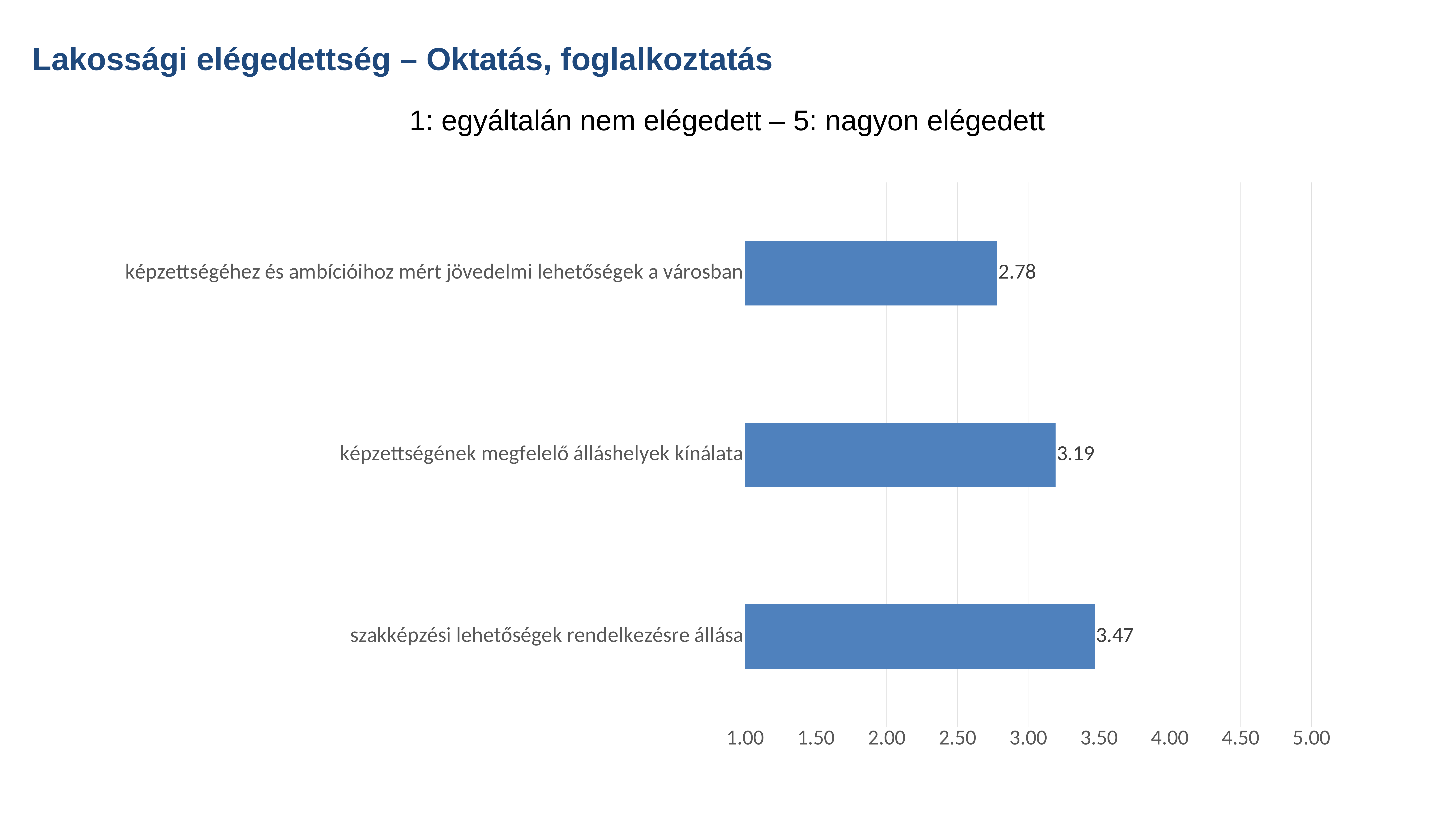
How many categories are shown in the chart? 3 Which category has the highest value? szakképzési lehetőségek rendelkezésre állása Which category has the lowest value? képzettségéhez és ambícióihoz mért jövedelmi lehetőségek a városban What is the difference between the values for "szakképzési lehetőségek rendelkezésre állása" and "képzettségéhez és ambícióihoz mért jövedelmi lehetőségek a városban"? 0.69 Is the value for "képzettségéhez és ambícióihoz mért jövedelmi lehetőségek a városban" greater or less than 3.00? less What kind of chart is shown on the slide? bar chart What is the difference between the values for "képzettségének megfelelő álláshelyek kínálata" and "képzettségéhez és ambícióihoz mért jövedelmi lehetőségek a városban"? 0.41 What is the value for "képzettségéhez és ambícióihoz mért jövedelmi lehetőségek a városban"? 2.78 What is the title of the chart? 1: egyáltalán nem elégedett – 5: nagyon elégedett What is the value for "szakképzési lehetőségek rendelkezésre állása"? 3.47 What is the value for "képzettségének megfelelő álláshelyek kínálata"? 3.19 Which is larger: the value for "képzettségének megfelelő álláshelyek kínálata" or for "képzettségéhez és ambícióihoz mért jövedelmi lehetőségek a városban"? képzettségének megfelelő álláshelyek kínálata